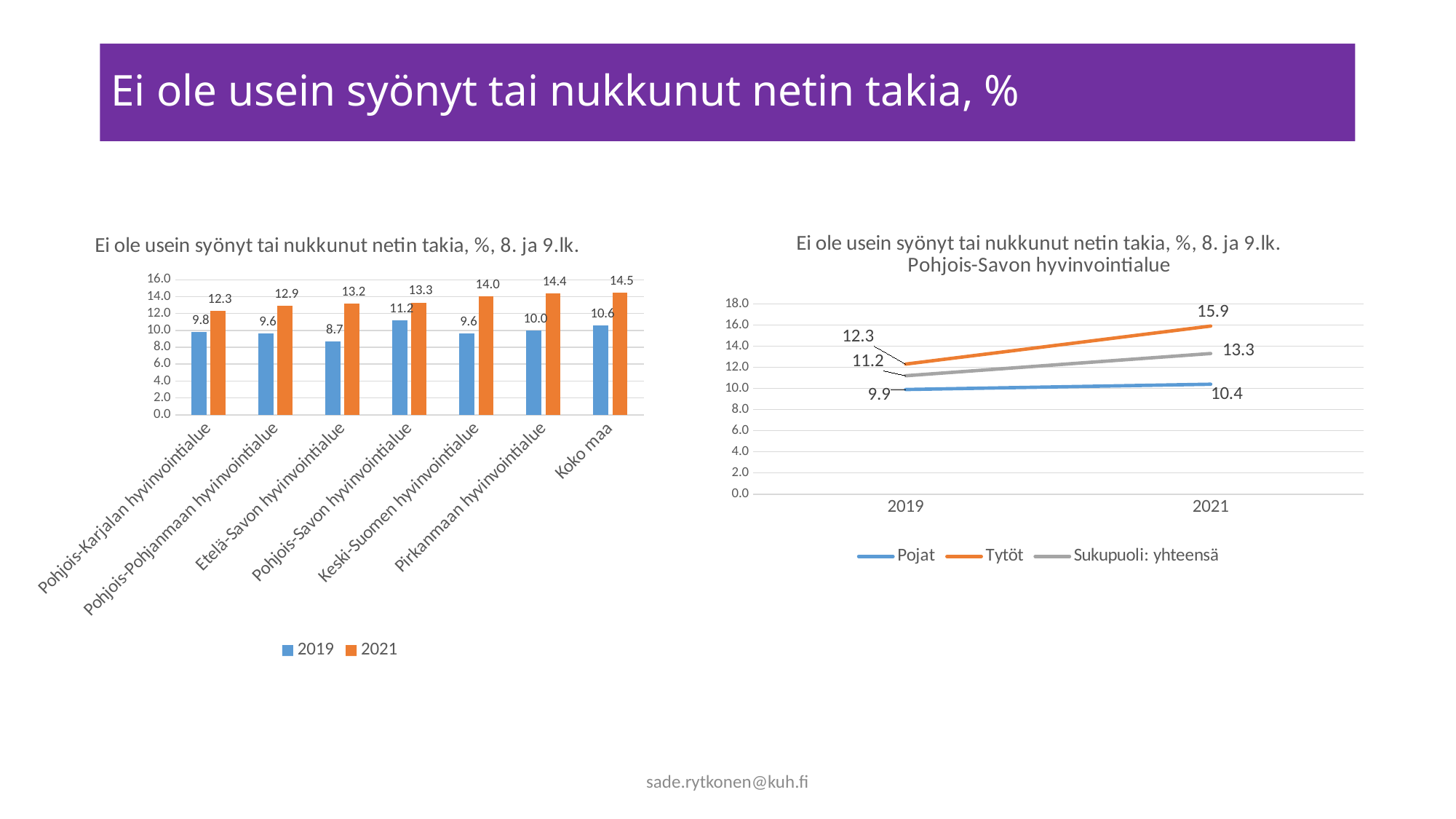
In the left bar chart, what is the 2019 value for Etelä-Savon hyvinvointialue? 8.7 In the left bar chart, what is the difference between the 2021 and 2019 values for Pohjois-Savon hyvinvointialue? 2.1 In the right line chart, what is the value for Tytöt in 2021? 15.9 What type of chart is the chart on the right side of the slide? line chart In the left bar chart, what is the 2021 value for Koko maa? 14.5 In the right line chart, how many series does the legend list? 3 In the right line chart, what is the value for Pojat in 2019? 9.9 In the right line chart, does the Tytöt series rise or fall from 2019 to 2021? rise In the left bar chart, which category has the highest 2021 value? Koko maa In the left bar chart, which category has the lowest 2019 value? Etelä-Savon hyvinvointialue In the left bar chart, how many categories are shown on the x axis? 7 In the left bar chart, is the 2019 value for Pirkanmaan hyvinvointialue greater or less than the 2021 value? less